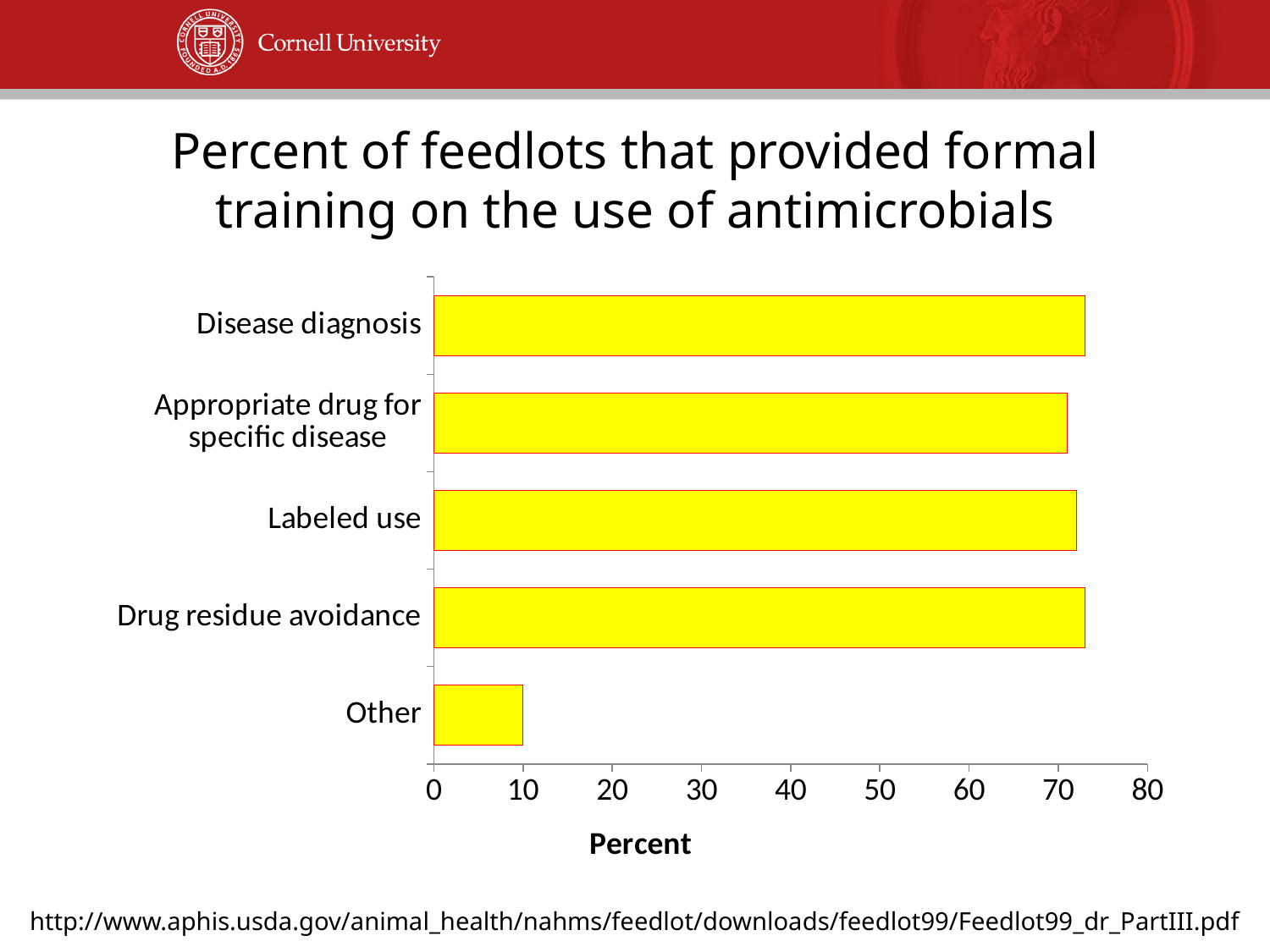
Is the value for Appropriate drug for specific disease greater or less than 50? greater How many categories are plotted in the chart? 5 Which is larger, the value for Other or the value for Drug residue avoidance? Drug residue avoidance Is the value for Drug residue avoidance greater or less than 80? less Is the value for Disease diagnosis greater or less than 70? greater Which category has the lowest value in the chart? Other What is the title of the chart's horizontal axis? Percent What kind of chart is shown on the slide? bar chart What is the title of the chart? Percent of feedlots that provided formal training on the use of antimicrobials Which is larger, the value for Labeled use or the value for Other? Labeled use